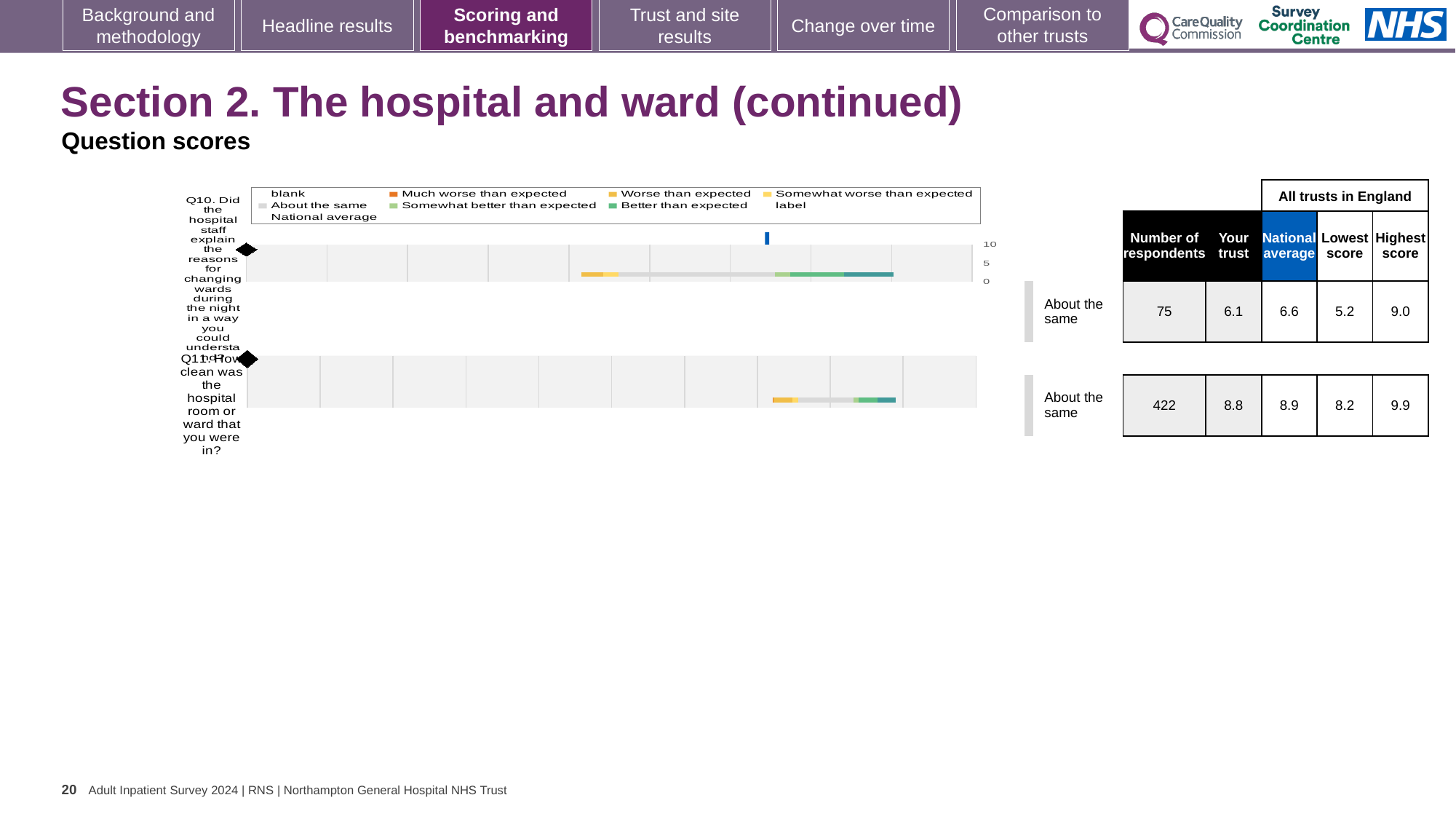
For Q11, what is the difference between the highest score (9.9) and the lowest score (8.2) across all trusts? 1.7 For Q11 (how clean was the hospital room or ward), how many respondents are shown? 422 For Q11, what is the score for your trust? 8.8 How many questions are plotted on this slide? 2 For Q10, what is the score for your trust? 6.1 For Q10, what is the highest score among all trusts in England? 9.0 What benchmark category is shown for Q11? About the same For Q10 (explaining reasons for changing wards during the night), how many respondents are shown? 75 For Q10, what is the national average score? 6.6 For Q11, what is the lowest score among all trusts in England? 8.2 Which question had more respondents, Q10 or Q11? Q11 For Q10, how much lower is your trust's score than the national average? 0.5